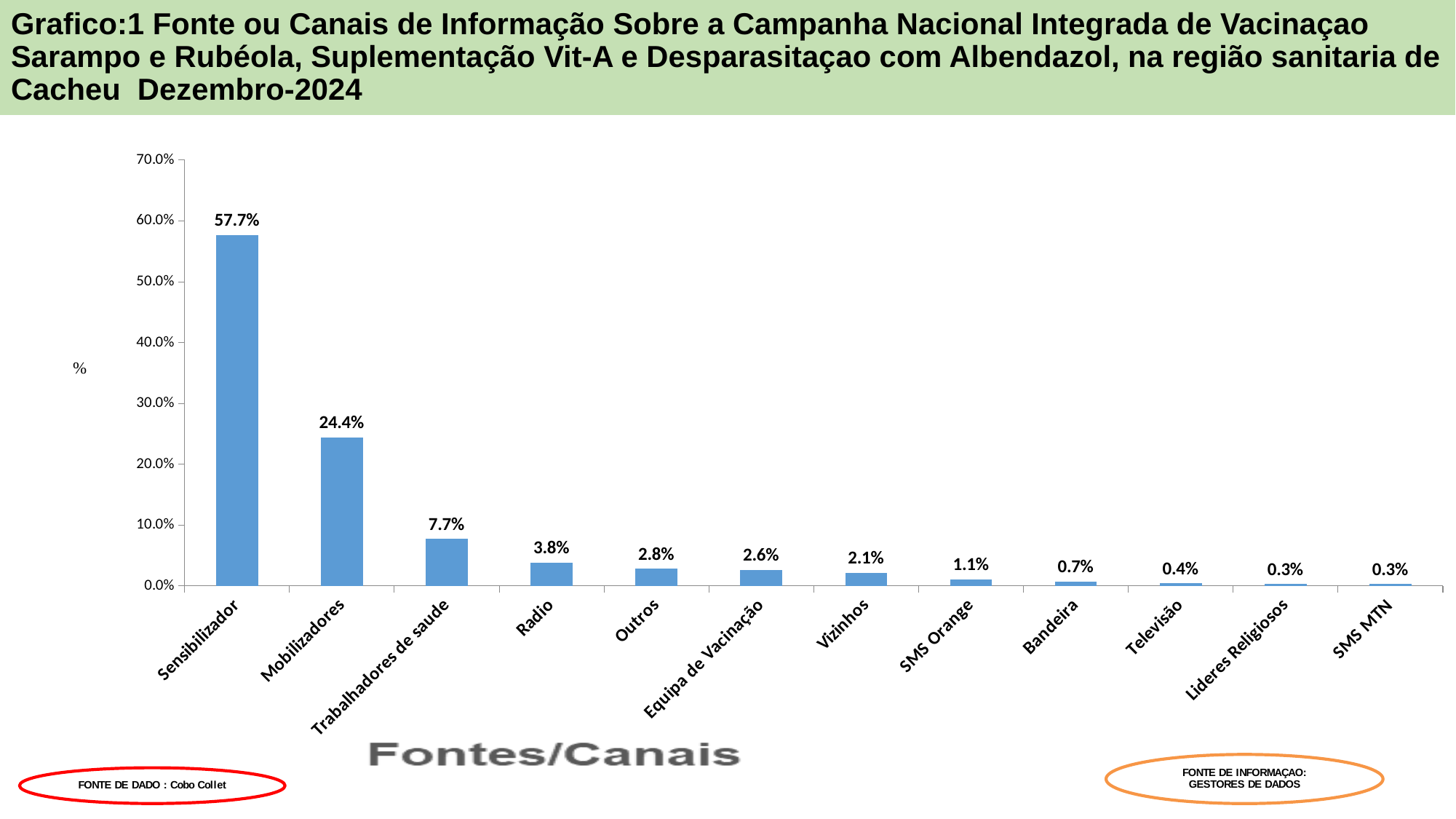
What is the value for Radio? 3.8% What is the label of the x axis? Fontes/Canais Which source or channel has the highest percentage? Sensibilizador What percentage is shown for Trabalhadores de saude? 7.7% What percentage is shown for Sensibilizador? 57.7% Which has a larger value, Vizinhos or Equipa de Vacinação? Equipa de Vacinação What is the difference between the values for Radio and Outros? 1.0 percentage point What percentage is shown for SMS Orange? 1.1% What is the value for Mobilizadores? 24.4% What type of chart is shown on the slide? Bar chart How many sources or channels are shown on the x axis? 12 What is the difference between the values for Sensibilizador and Mobilizadores? 33.3 percentage points